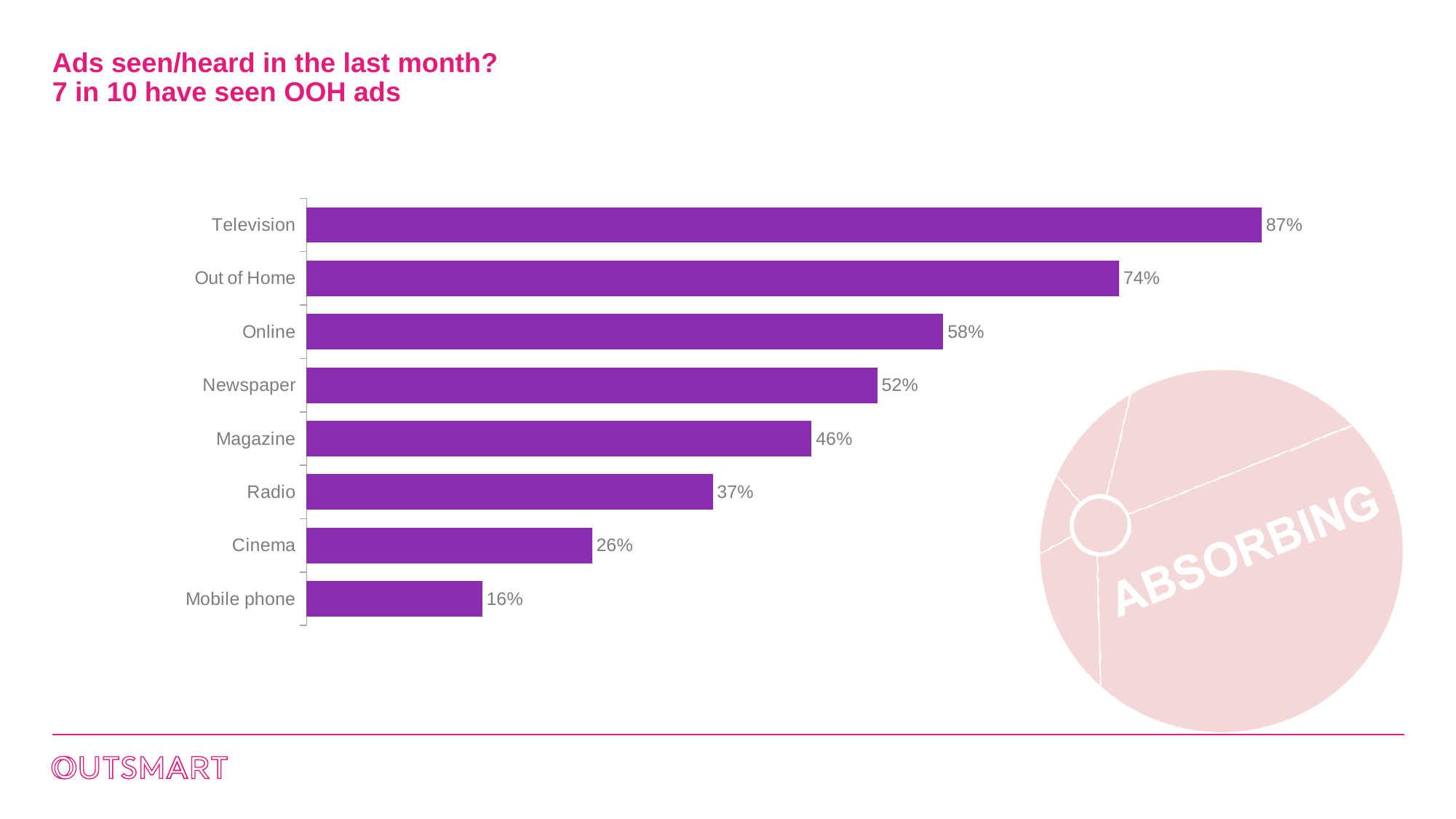
What is the difference between the Online and Newspaper values? 6% Which is larger, the value for Magazine or the value for Radio? Magazine What is the value for Mobile phone? 16% What type of chart is shown on the slide? Bar chart How many media categories are shown in the chart? 8 What is the value shown for Out of Home? 74% Which medium has the highest percentage of ads seen/heard in the last month? Television What is the difference between the Television and Out of Home percentages? 13% Which medium has the lowest percentage? Mobile phone What colour are the bars in the chart? Purple What percentage is shown for Radio? 37% What percentage of people saw or heard Television ads in the last month? 87%